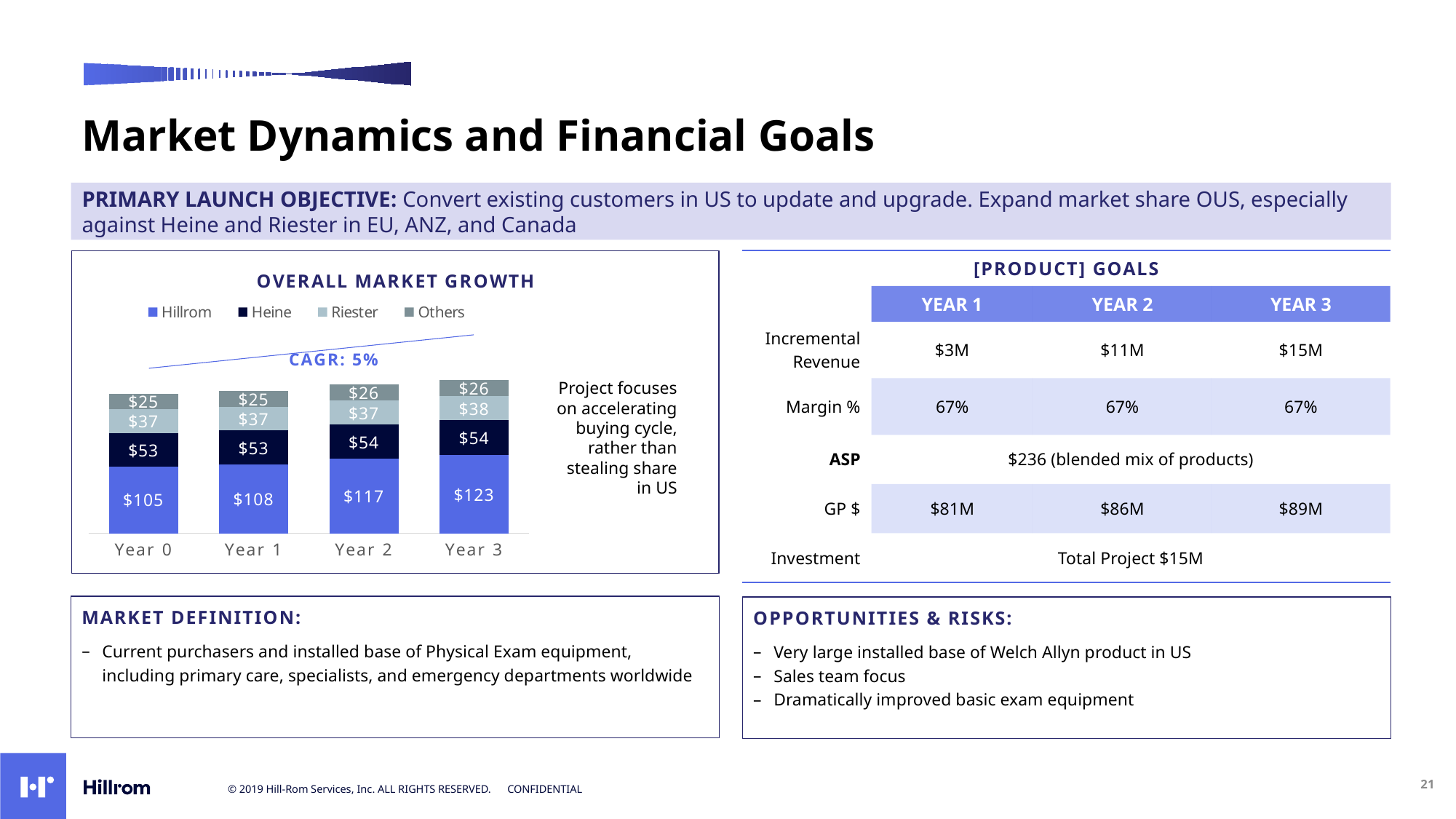
What is the Heine value for Year 0 in the "OVERALL MARKET GROWTH" chart? $53 What type of chart is shown under the title "OVERALL MARKET GROWTH"? Stacked bar chart In which year is the Hillrom value lowest in the "OVERALL MARKET GROWTH" chart? Year 0 What is the Hillrom value for Year 3 in the "OVERALL MARKET GROWTH" chart? $123 What is the difference between the Hillrom values for Year 3 and Year 0 in the "OVERALL MARKET GROWTH" chart? $18 What is the total of the stacked bar for Year 0 in the "OVERALL MARKET GROWTH" chart? $220 What is the Others value for Year 2 in the "OVERALL MARKET GROWTH" chart? $26 How many series does the legend of the "OVERALL MARKET GROWTH" chart list? 4 How many year categories are plotted on the x axis of the "OVERALL MARKET GROWTH" chart? 4 What is the Riester value for Year 3 in the "OVERALL MARKET GROWTH" chart? $38 In which year is the Hillrom value highest in the "OVERALL MARKET GROWTH" chart? Year 3 Does the Hillrom value rise or fall from Year 0 to Year 3 in the "OVERALL MARKET GROWTH" chart? Rise